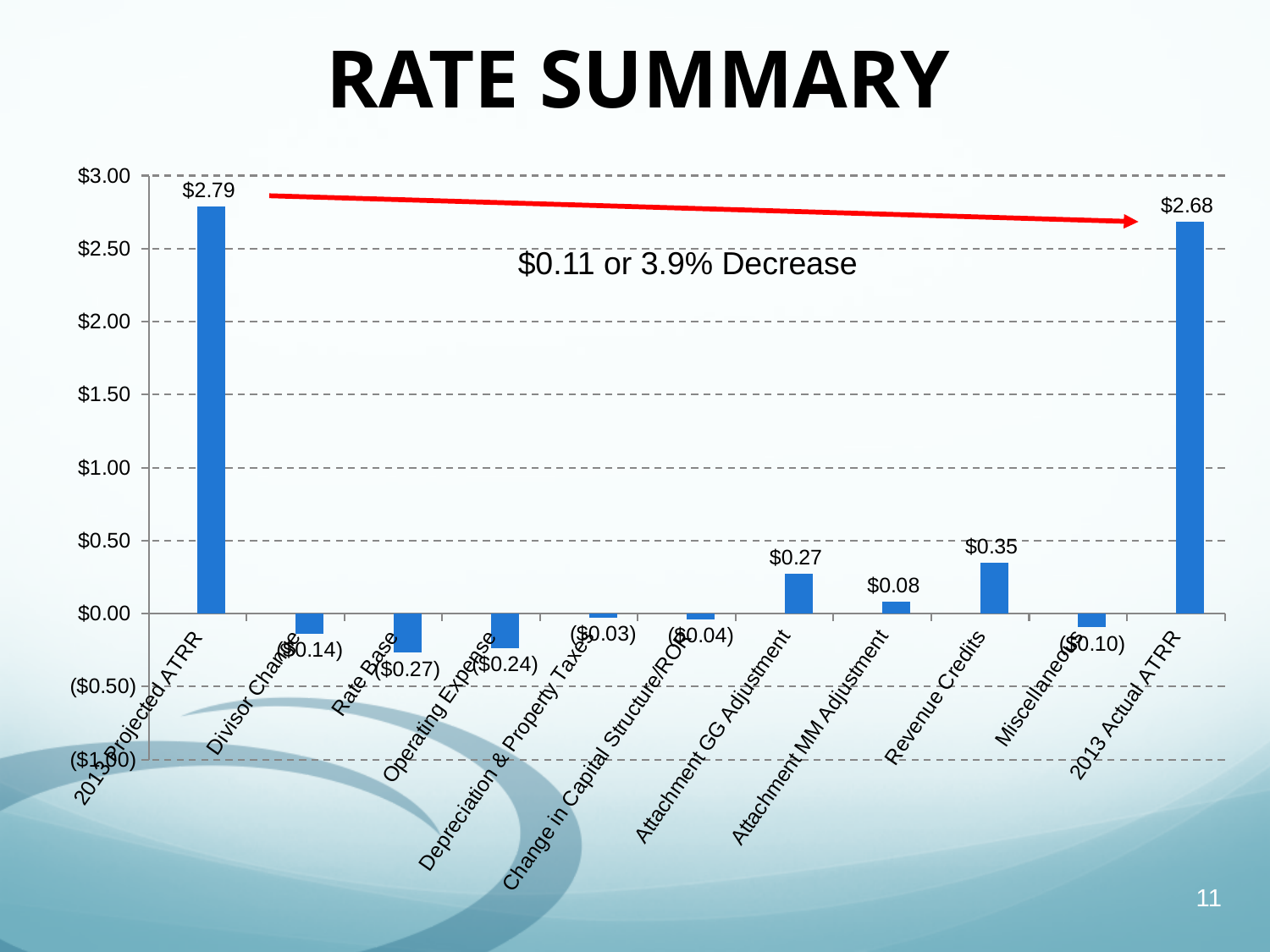
What is the value for Attachment MM Adjustment? $0.08 What kind of chart is shown on the slide? Bar chart Which is larger, the value for Attachment GG Adjustment or the value for Revenue Credits? Revenue Credits Which category has the highest value? 2013 Projected ATRR Which category has the lowest value? Rate Base What is the difference between 2013 Projected ATRR and 2013 Actual ATRR? $0.11 What is the value for 2013 Actual ATRR? $2.68 How many categories are shown on the x axis? 11 What does the text annotation in the middle of the chart say? $0.11 or 3.9% Decrease What is the value for Rate Base? ($0.27) What is the value for 2013 Projected ATRR? $2.79 What is the value for Revenue Credits? $0.35